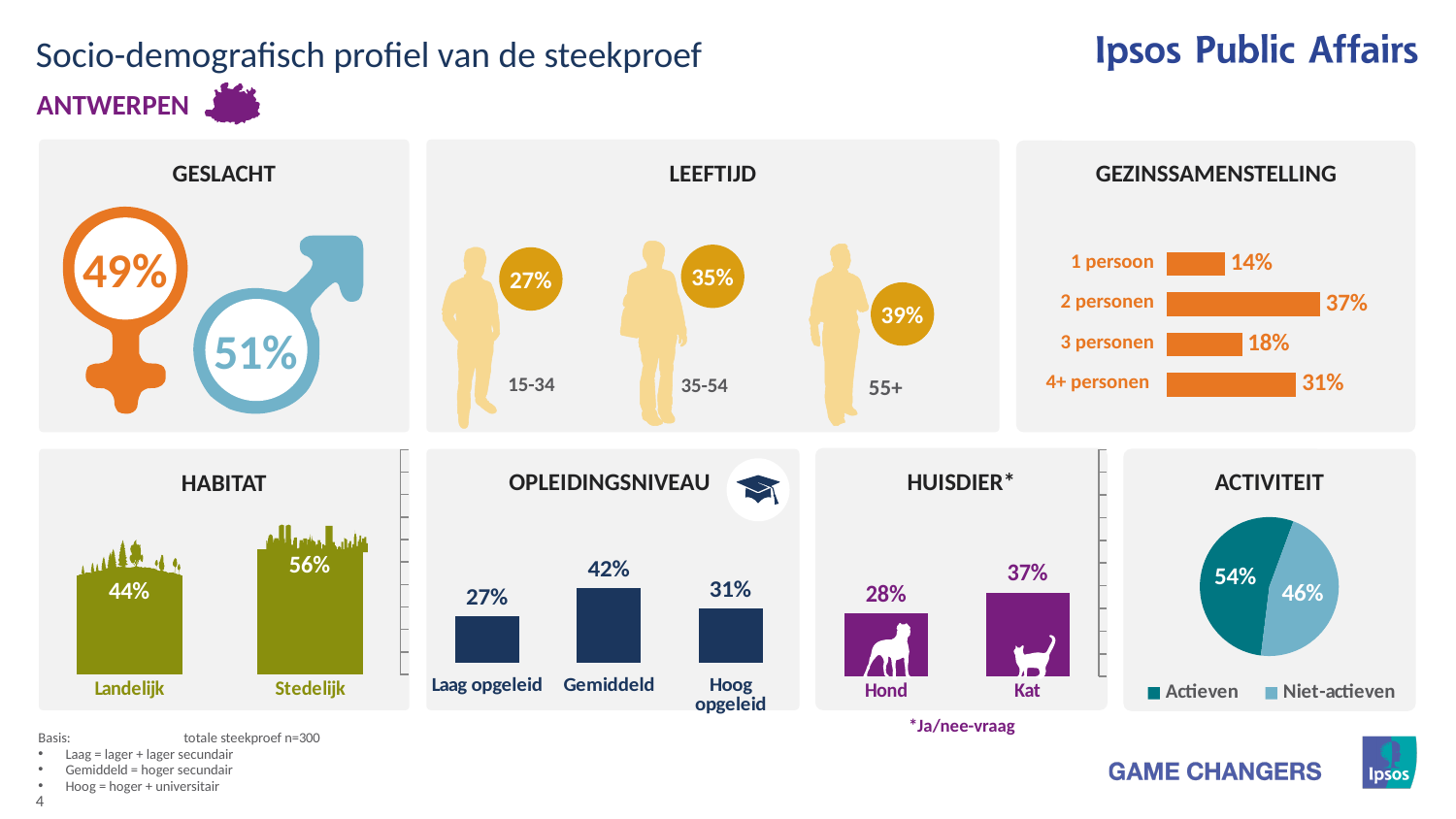
In the ACTIVITEIT chart, what share is Niet-actieven? 46% In the HUISDIER chart, what is the difference between Kat and Hond? 9% In the GEZINSSAMENSTELLING chart, which household size has the lowest value? 1 persoon In the OPLEIDINGSNIVEAU chart, which category has the highest value? Gemiddeld In the GEZINSSAMENSTELLING chart, what is the value for 2 personen? 37% How many series does the legend of the ACTIVITEIT chart list? 2 In the HABITAT chart, what is the value for Stedelijk? 56% What kind of chart is the ACTIVITEIT chart? pie chart In the OPLEIDINGSNIVEAU chart, what is the value for Hoog opgeleid? 31% How many categories does the GEZINSSAMENSTELLING chart show? 4 In the GEZINSSAMENSTELLING chart, what is the difference between 4+ personen and 3 personen? 13% In the HABITAT chart, which category is larger, Landelijk or Stedelijk? Stedelijk